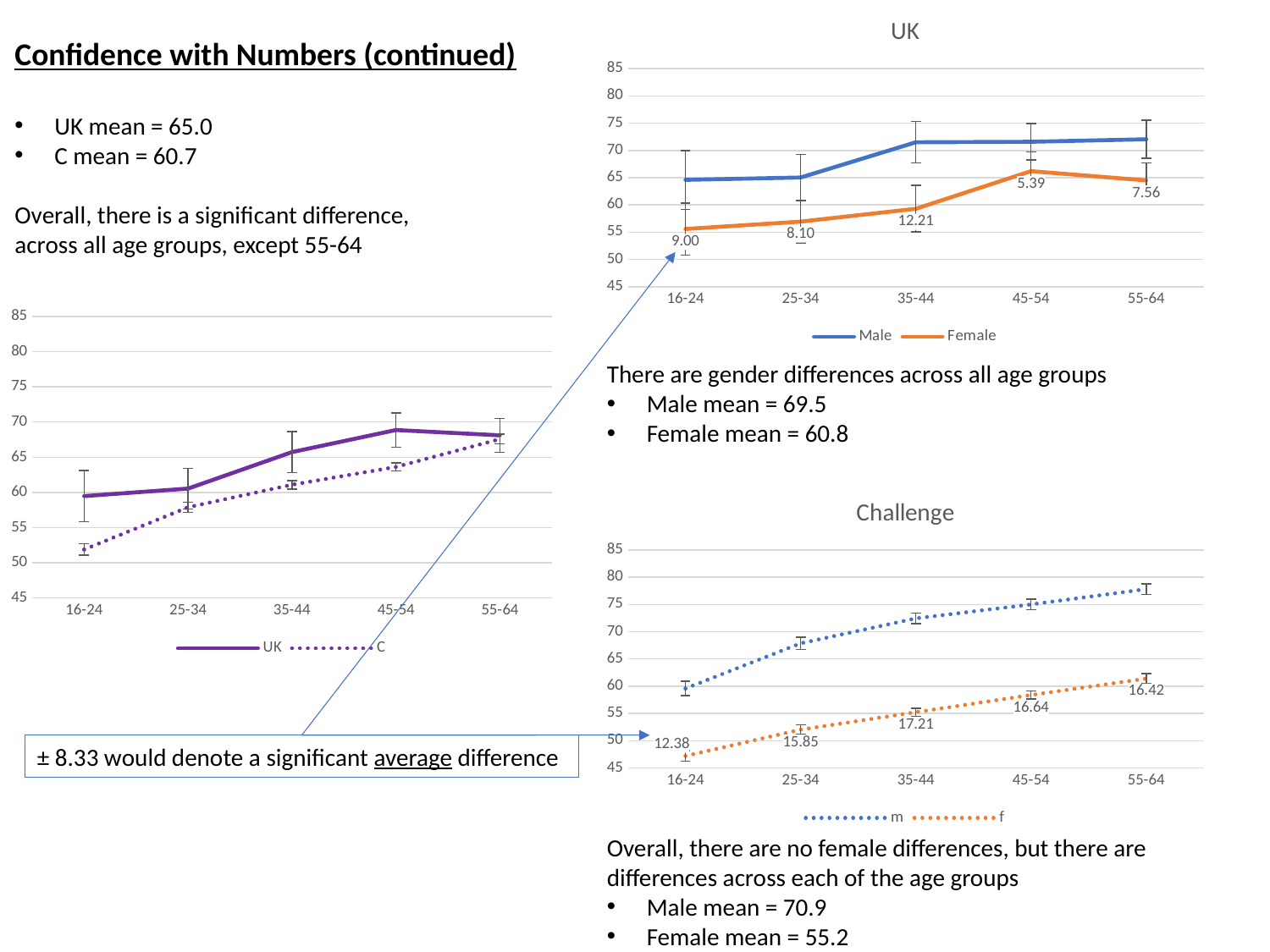
On the left-hand chart, which series has the larger value at 16-24, UK or C? UK What are the two legend entries of the chart titled "Challenge"? m and f On the chart titled "Challenge", is the value for m at 55-64 greater or less than 75? greater On the chart titled "UK", what data label is shown at the 45-54 age group? 5.39 On the chart titled "Challenge", does the m series rise or fall from 16-24 to 55-64? rise What kind of chart is the chart titled "UK"? line chart On the chart titled "Challenge", what data label is shown at the 35-44 age group? 17.21 On the chart titled "UK", which age group has the smallest printed data label? 45-54 How many age groups are shown on the x axis of the chart titled "Challenge"? 5 On the chart titled "Challenge", which age group has the largest printed data label? 35-44 On the chart titled "Challenge", is the value for f at 16-24 greater or less than 50? less How many series does the legend of the left-hand chart list? 2